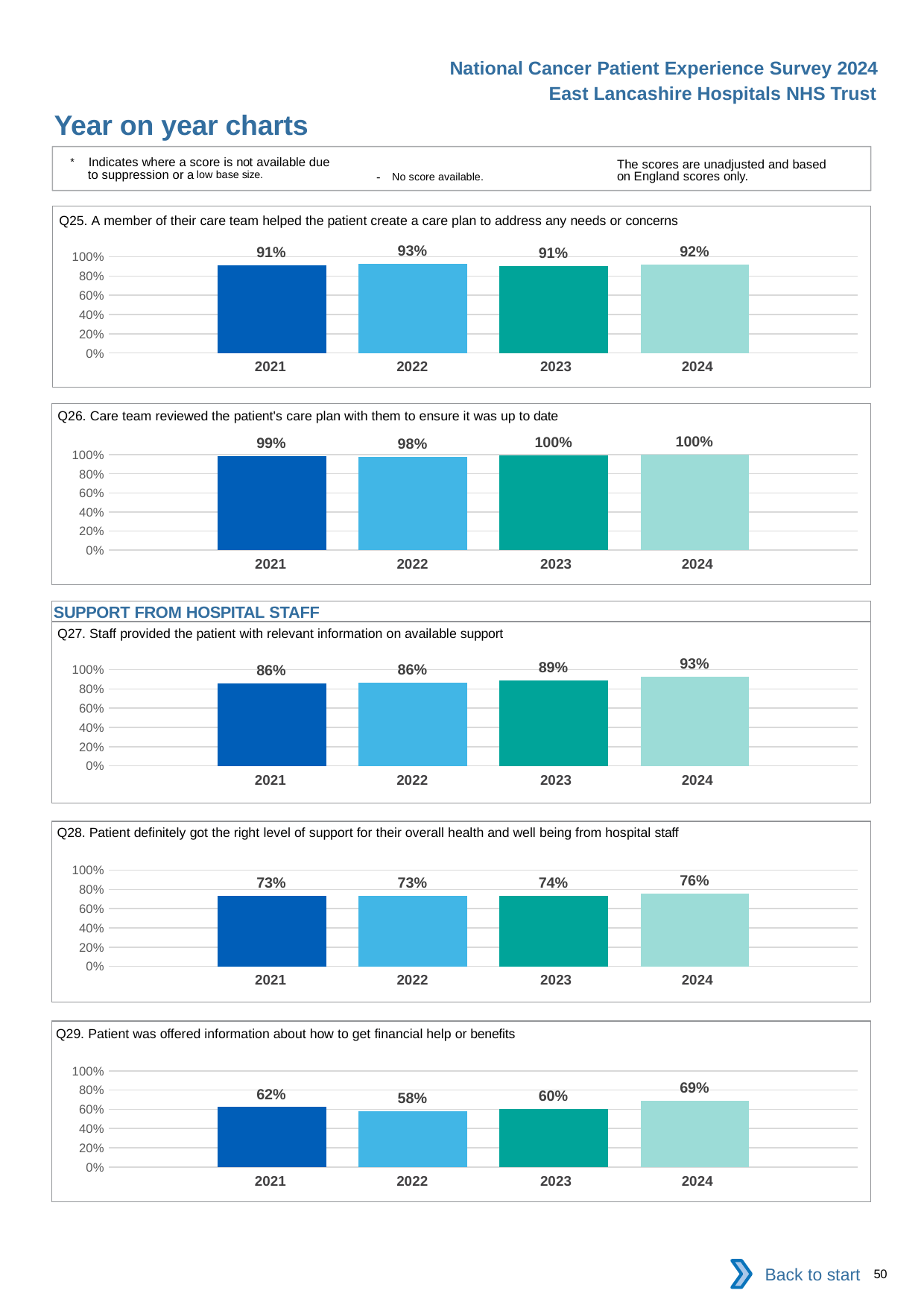
In the Q26 chart, what is the value for 2023? 100% In the Q29 chart, is the value for 2024 greater or less than 80%? less In the Q28 chart, which year has the highest value? 2024 In the Q27 chart, what is the difference between the 2024 and 2021 values? 7% In the Q29 chart, what is the value for 2022? 58% How many years are shown in the Q27 chart? 4 In the Q25 chart, what is the value for 2022? 93% In the Q26 chart, which year has the lowest value? 2022 What kind of chart is the Q28 chart? bar chart In the Q27 chart, do the values rise or fall from 2022 to 2024? rise How many charts are shown on the slide? 5 In the Q29 chart, which is larger, the value for 2021 or the value for 2023? 2021